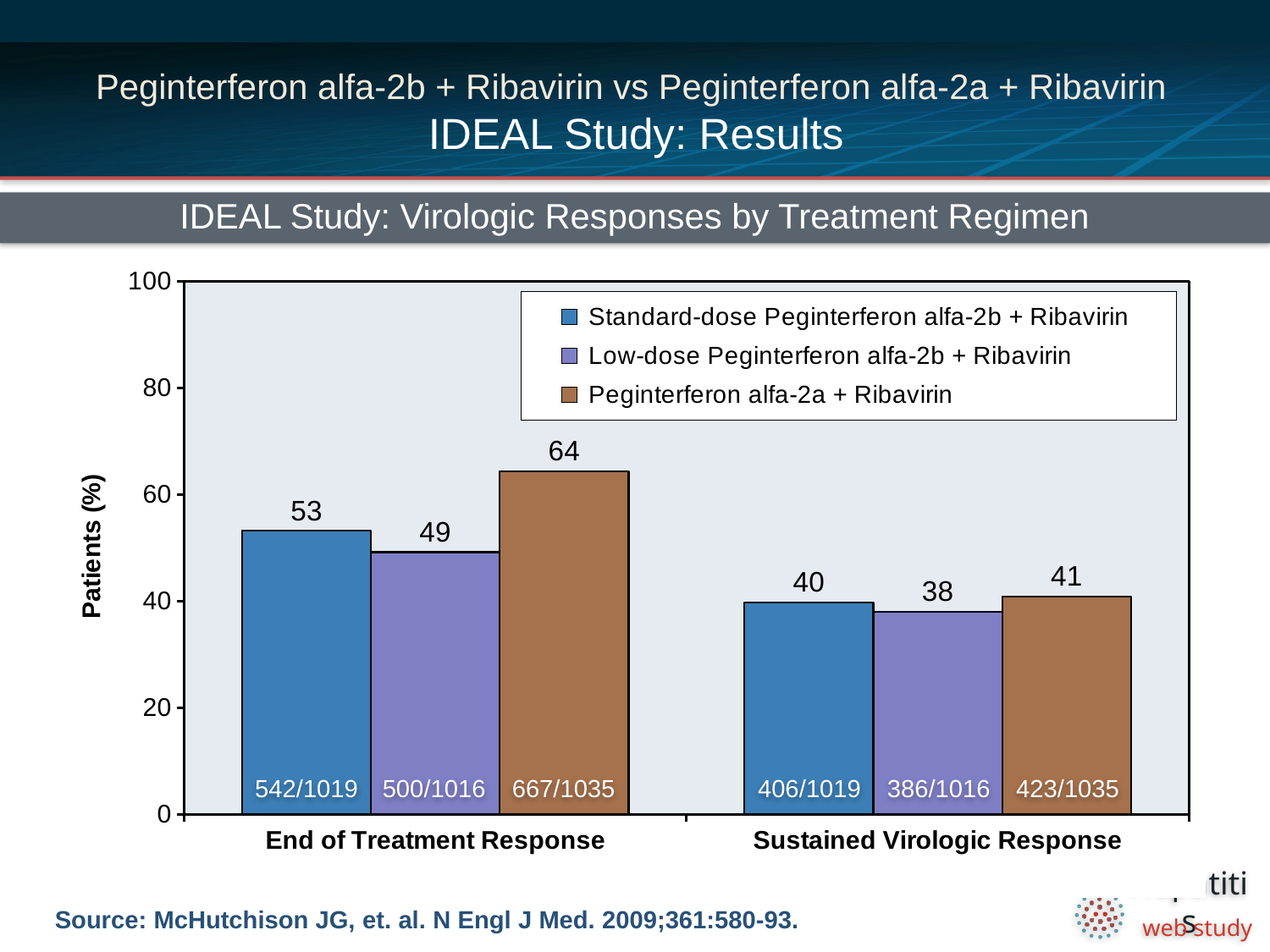
Is the Sustained Virologic Response value for Peginterferon alfa-2a + Ribavirin greater or less than 60? less What is the label of the y axis? Patients (%) What is the Sustained Virologic Response value for Low-dose Peginterferon alfa-2b + Ribavirin? 38 Which is larger for Standard-dose Peginterferon alfa-2b + Ribavirin: End of Treatment Response or Sustained Virologic Response? End of Treatment Response What is the End of Treatment Response value for Standard-dose Peginterferon alfa-2b + Ribavirin? 53 How many categories are shown on the x axis? 2 Which treatment regimen has the highest End of Treatment Response? Peginterferon alfa-2a + Ribavirin How many series does the legend list? 3 What is the difference between the End of Treatment Response values for Peginterferon alfa-2a + Ribavirin and Low-dose Peginterferon alfa-2b + Ribavirin? 15 Which treatment regimen has the lowest Sustained Virologic Response? Low-dose Peginterferon alfa-2b + Ribavirin What kind of chart is shown on the slide? Bar chart What is the End of Treatment Response value for Peginterferon alfa-2a + Ribavirin? 64